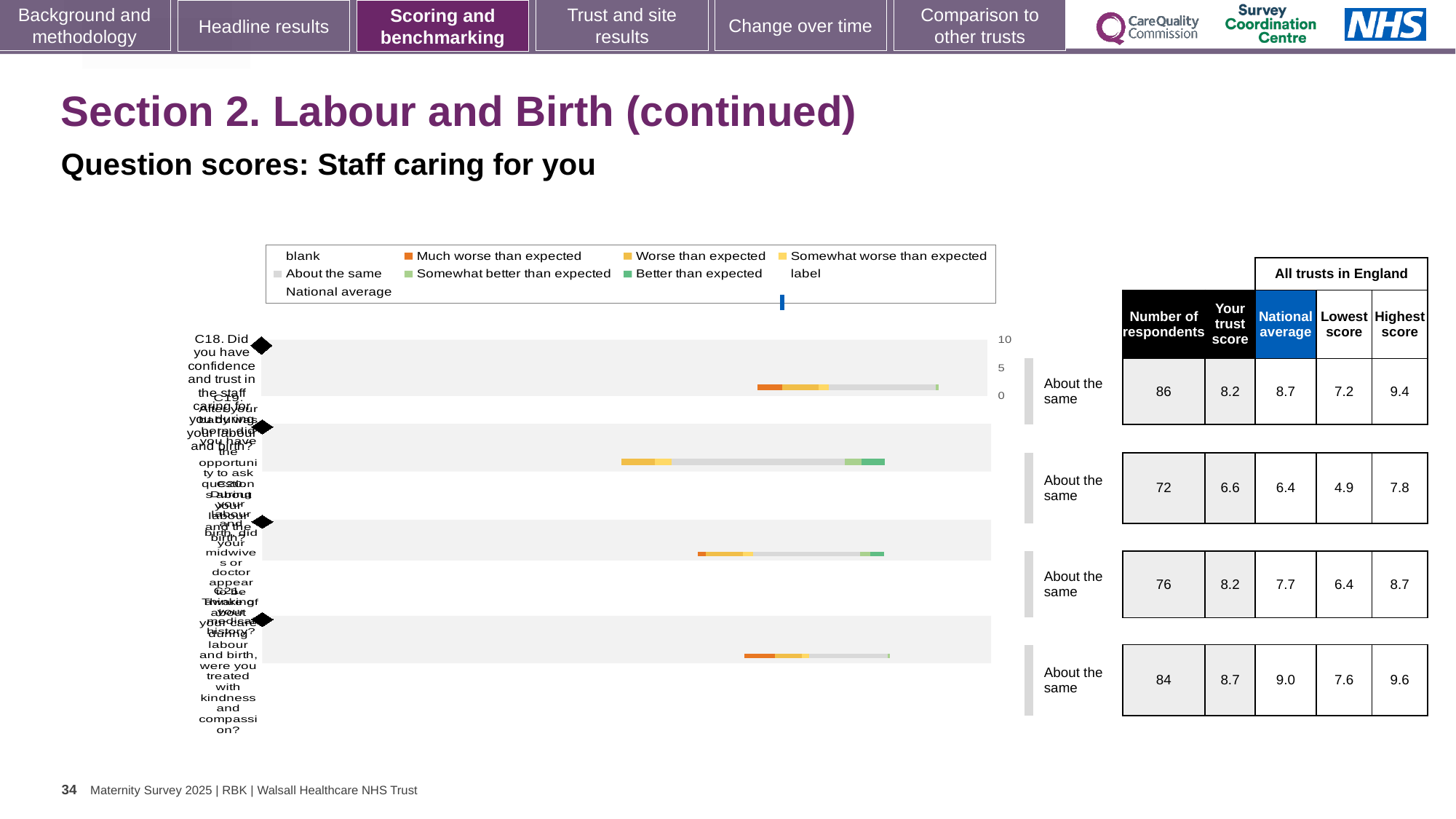
What is the number of respondents for question C18 (the first row of the table)? 86 What colour represents 'Much worse than expected' in the chart legend? Orange In the second row of the table, which is larger: the trust score or the national average? The trust score (6.6) How many questions (bars) are plotted in the chart? 4 What is the national average for question C18 (the first row of the table)? 8.7 For the first row of the table, what is the difference between the highest score (9.4) and the lowest score (7.2)? 2.2 What is the lowest number of respondents shown in the table? 72 What is the subtitle of the chart section on the slide? Question scores: Staff caring for you What is the lowest score for the fourth row of the table? 7.6 What is the 'Your trust score' value for question C18 (the first row of the table)? 8.2 What kind of chart is shown on the slide? bar chart Which row of the table has the highest 'Your trust score', and what is it? The fourth row, 8.7